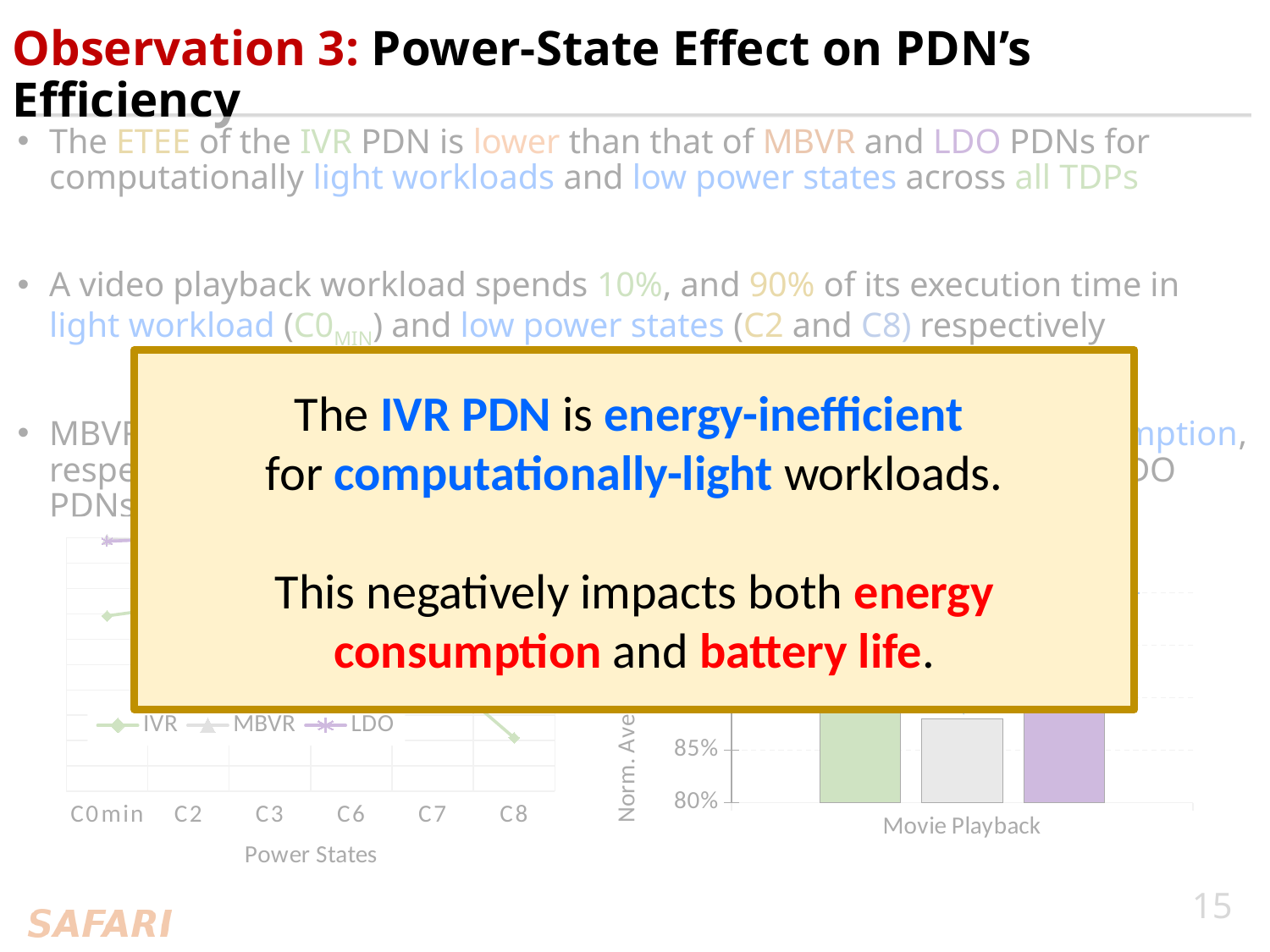
In the right chart, what is the category label shown on the x axis? Movie Playback In the right chart (Movie Playback), is the value of the green bar greater or less than 85%? greater In the left chart (Power States), how many power states are listed on the x axis? 6 In the right chart (Movie Playback), how many bars are plotted? 3 What kind of chart is the right chart with the category Movie Playback? bar chart What kind of chart is the left chart with the x axis labelled Power States? line chart In the left chart (Power States), which power state is the first category on the x axis? C0min In the left chart (Power States), what are the three series named in the legend? IVR, MBVR, LDO In the left chart (Power States), how many series does the legend list? 3 In the right chart (Movie Playback), is the value of the purple bar greater or less than 85%? greater